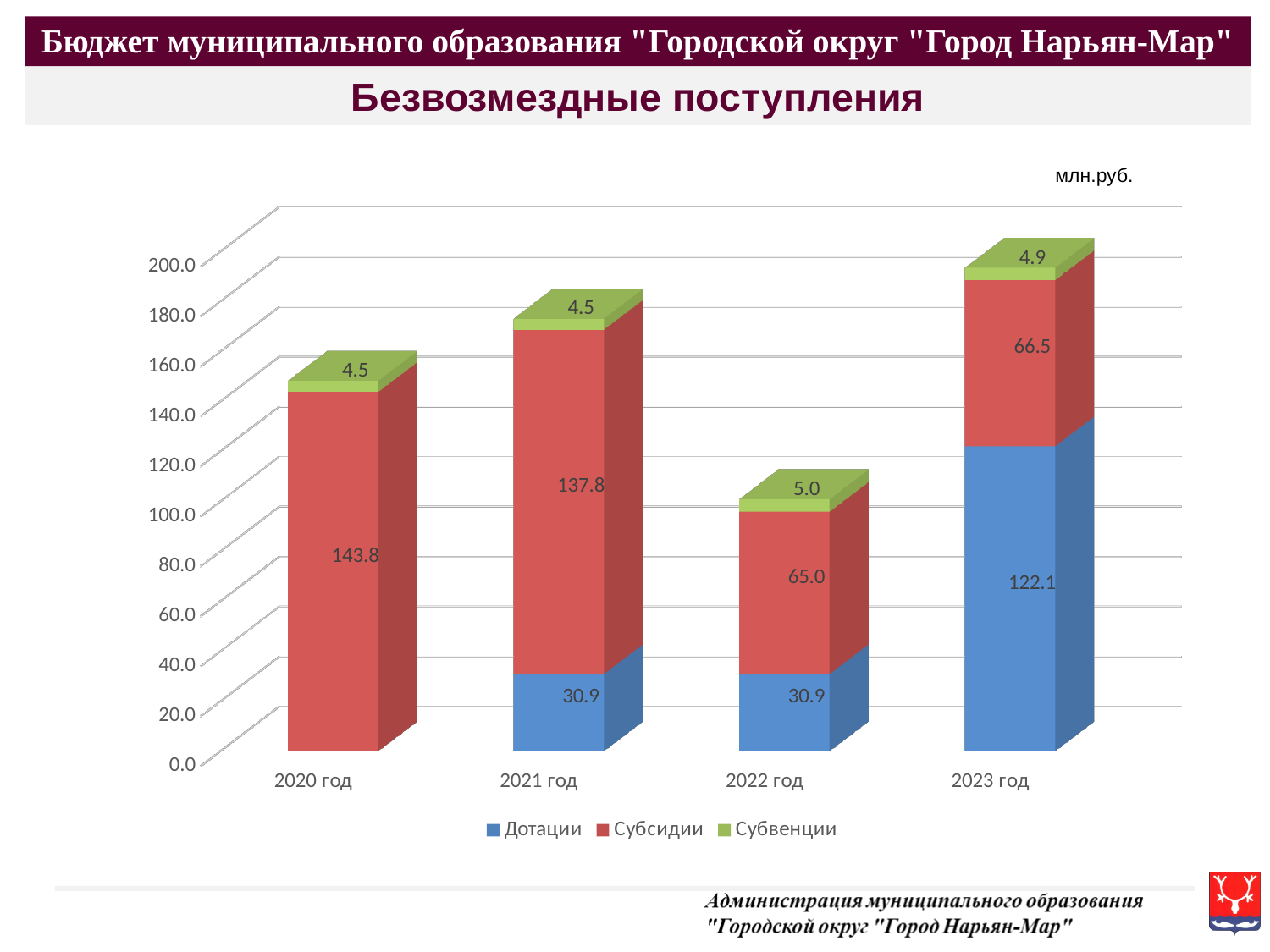
What is the total of the stacked bar for 2023 год? 193.5 What is the value of Субвенции for 2022 год? 5.0 What is the value of Субсидии for 2020 год? 143.8 What unit is indicated for the values in the chart? млн.руб. Which is larger: Субсидии for 2021 год or Субсидии for 2023 год? 2021 год What is the total of the stacked bar for 2022 год? 100.9 What is the value of Дотации for 2023 год? 122.1 Which year has the highest value for Субсидии? 2020 год What is the difference between the Дотации values for 2023 год and 2022 год? 91.2 How many series does the legend list? 3 Which year has the lowest value for Субсидии? 2022 год How many years are shown on the x axis? 4